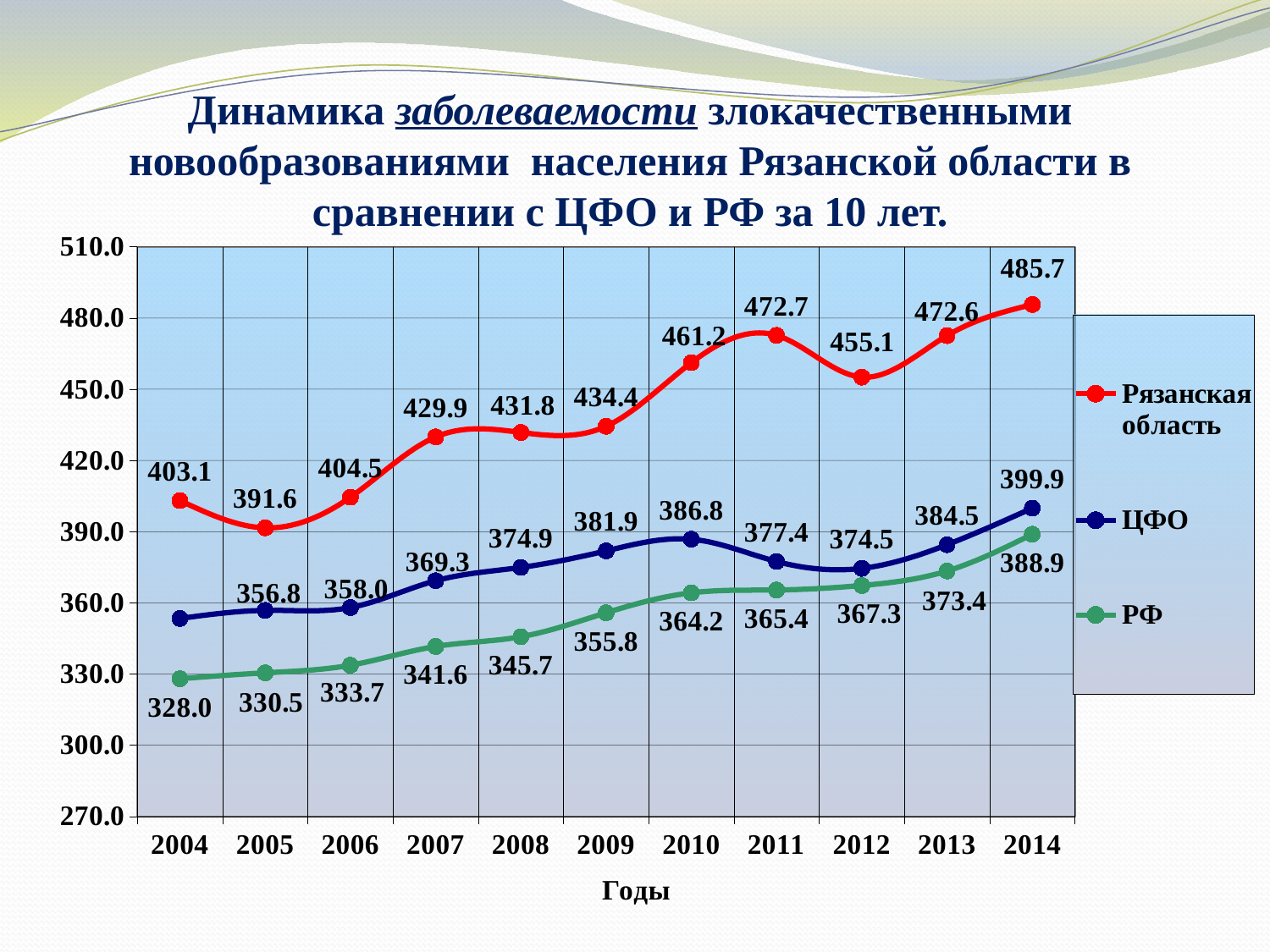
What is the value for Рязанская область in 2014? 485.7 Is the value for ЦФО in 2004 greater or less than 360? less In which year is the value for Рязанская область the lowest? 2005 How many series does the legend list? 3 What kind of chart is shown on the slide? line chart What is the value for РФ in 2004? 328.0 Which series has the larger value in 2012, ЦФО or РФ? ЦФО What is the difference between the Рязанская область values in 2014 and 2004? 82.6 In which year is the value for Рязанская область the highest? 2014 What is the difference between the ЦФО and РФ values in 2014? 11.0 How many years are shown on the x axis? 11 What is the value for ЦФО in 2010? 386.8